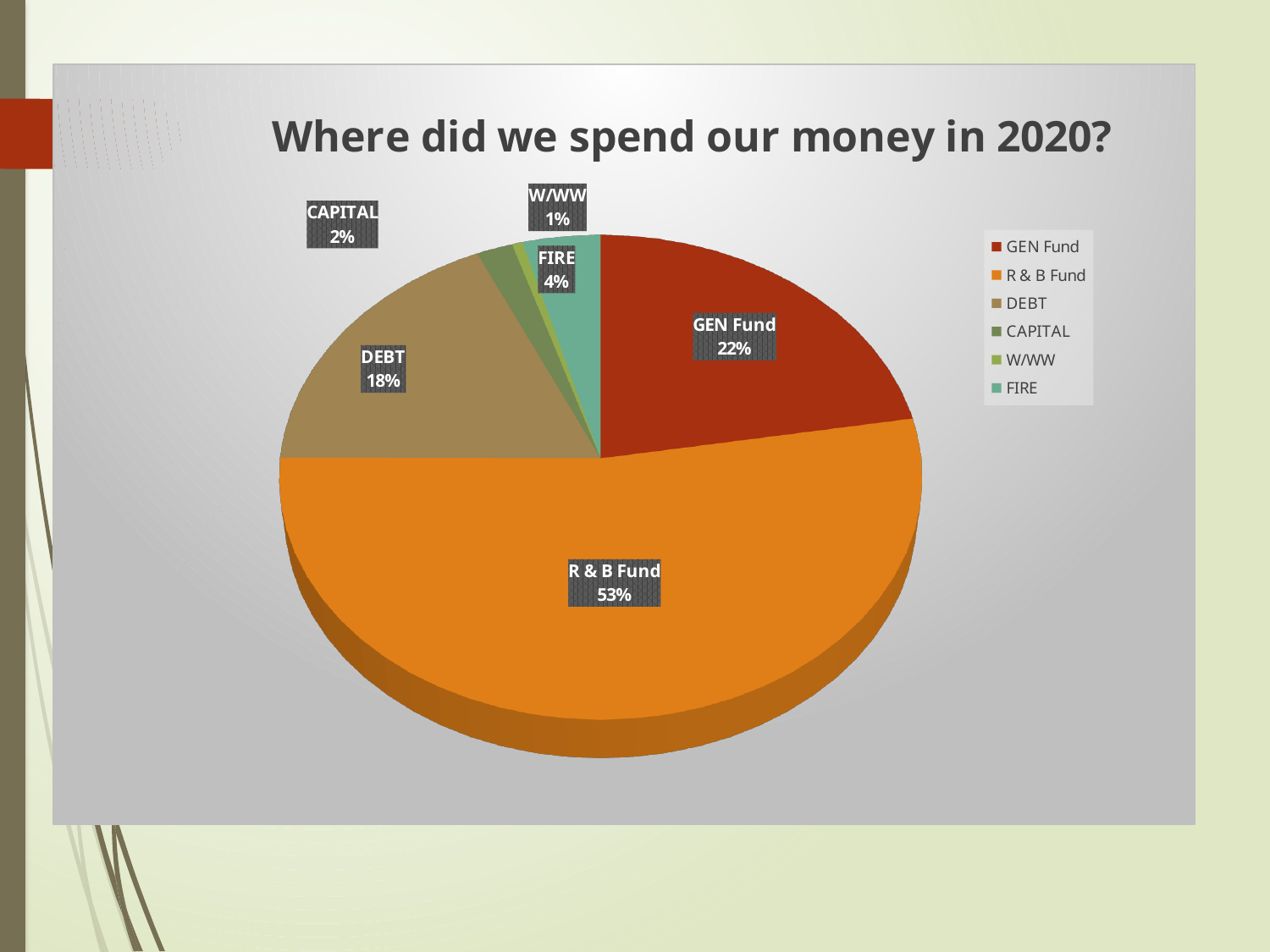
Which category has the largest slice of the pie? R & B Fund What percentage is shown for DEBT? 18% What share of spending went to the R & B Fund? 53% What percentage is shown for FIRE? 4% Which category has the smallest slice of the pie? W/WW What is the difference in percentage points between the R & B Fund and the GEN Fund? 31 How many categories does the pie chart show? 6 What is the combined percentage of CAPITAL and W/WW? 3% Which is larger, the DEBT slice or the GEN Fund slice? GEN Fund What percentage is shown for the GEN Fund slice? 22% What is the title of the chart? Where did we spend our money in 2020? What kind of chart is shown on the slide? Pie chart